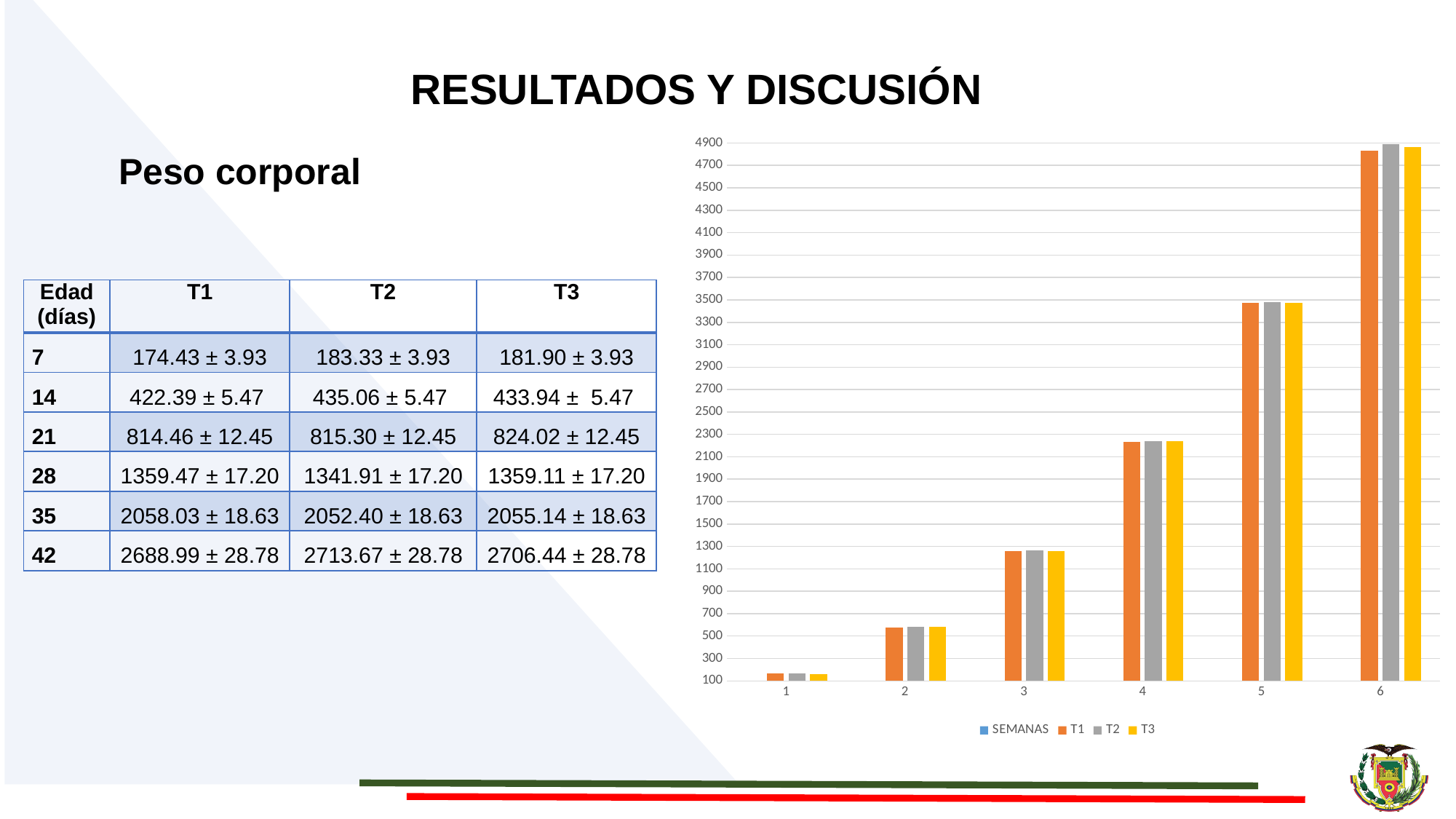
Do the bar values rise or fall from category 1 to category 6? rise Which category on the x axis has the tallest bars? 6 How many categories are shown on the x axis of the chart? 6 Is the value for T2 at category 5 greater or less than 3300? greater What colour are the T3 bars in the chart? yellow Is the value for T3 at category 4 greater or less than 2100? greater What kind of chart is shown on the slide? bar chart Which category on the x axis has the shortest bars? 1 Is the value for T1 at category 3 greater or less than 1300? less How many series does the chart legend list? 4